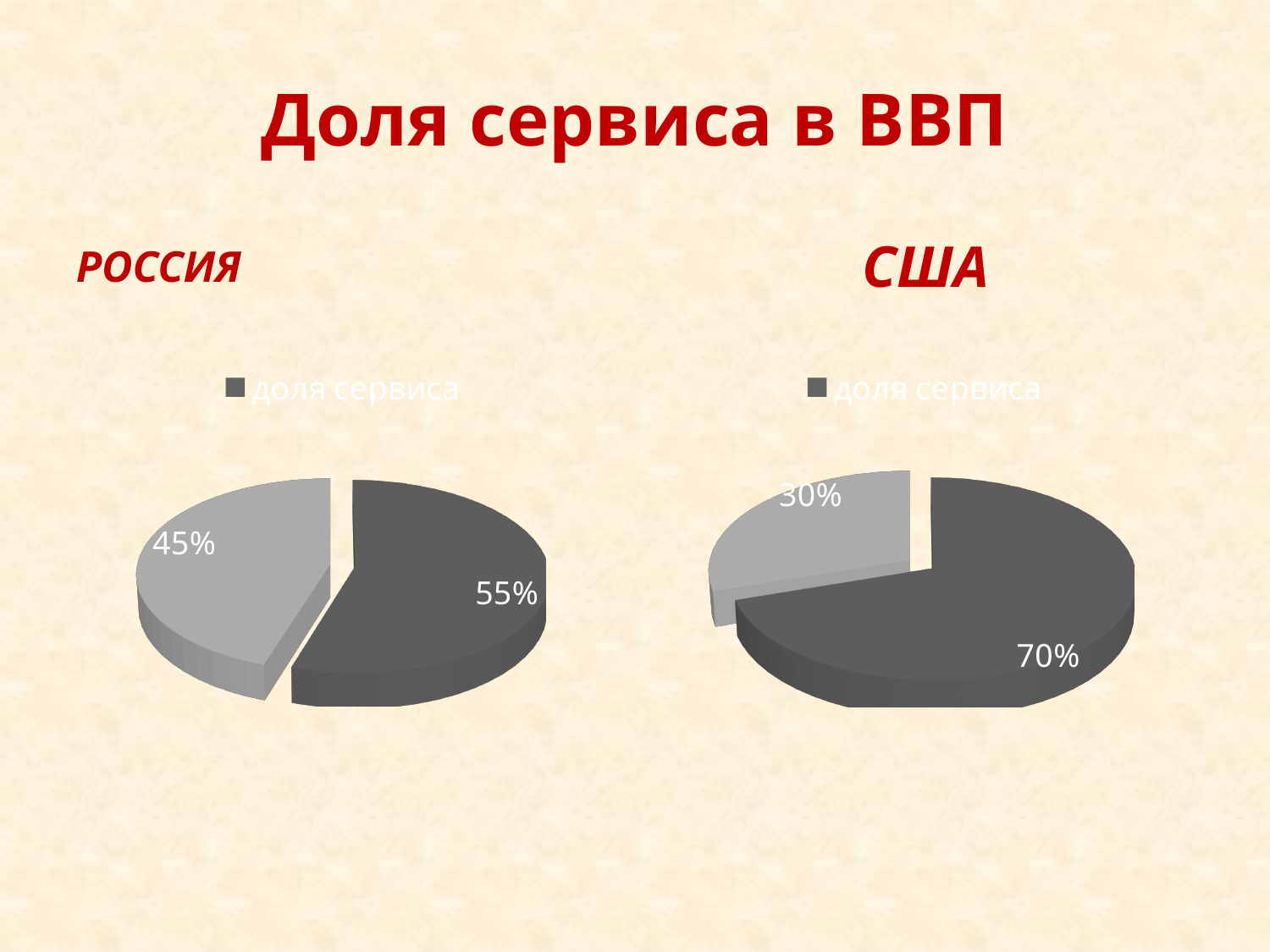
Which is larger: the dark slice in the РОССИЯ chart or the dark slice in the США chart? the dark slice in the США chart What is the title of the slide containing the two pie charts? Доля сервиса в ВВП In the РОССИЯ pie chart, what is the value of the larger (dark) slice? 55% In the США pie chart, what is the difference between the two slices? 40% What type of chart is shown under США? pie chart How many slices does the США pie chart have? 2 In the РОССИЯ pie chart, what is the value of the smaller (light) slice? 45% In the США pie chart, what is the value of the smaller (light) slice? 30% In the США pie chart, what is the value of the larger (dark) slice? 70% What type of chart is shown under РОССИЯ? pie chart In the РОССИЯ pie chart, what is the difference between the two slices? 10% What legend entry is shown above the РОССИЯ pie chart? доля сервиса